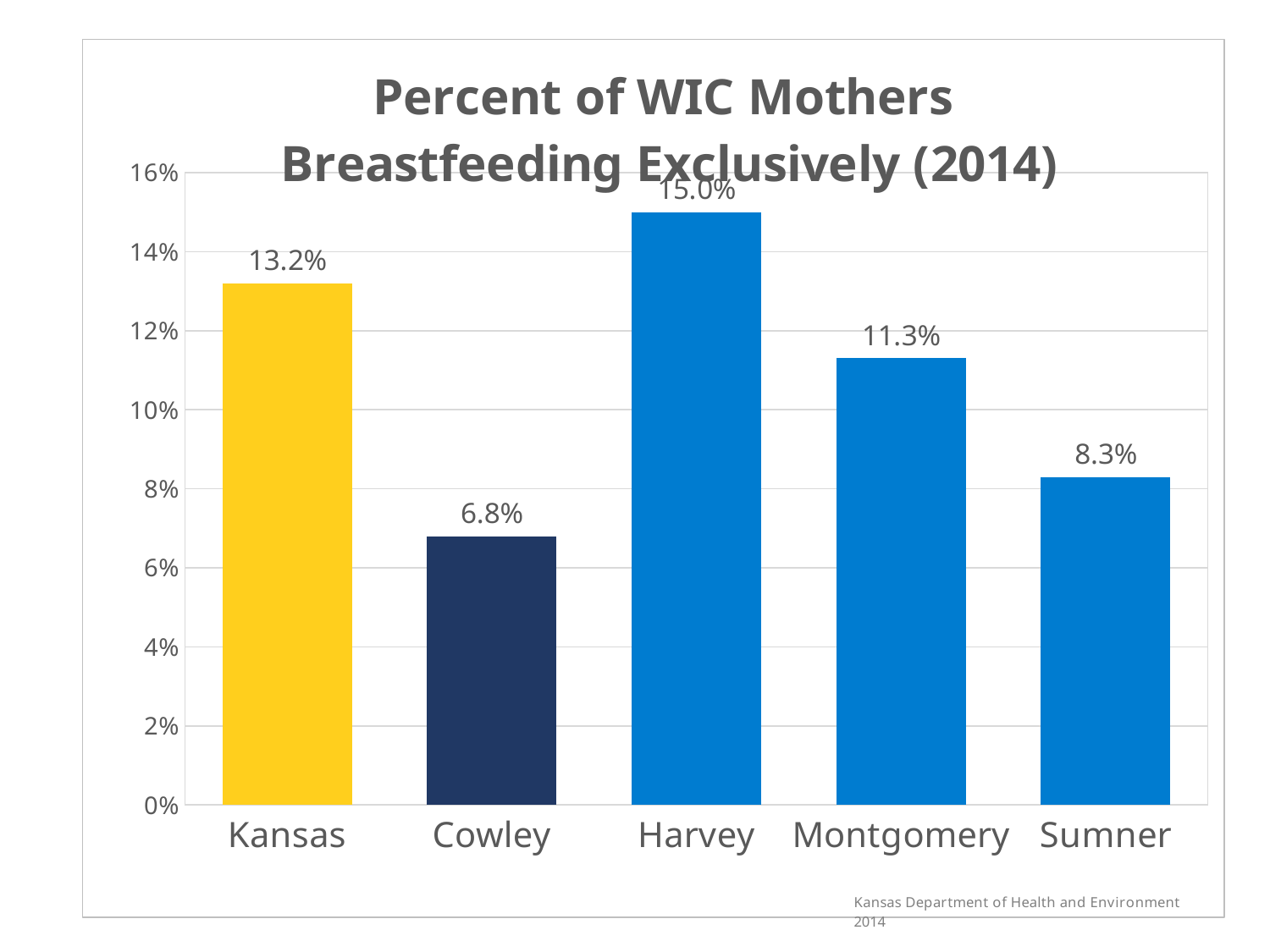
What is the difference between the values for Harvey and Cowley? 8.2% Which category has the highest value? Harvey What is the title of the chart? Percent of WIC Mothers Breastfeeding Exclusively (2014) What is the value for Sumner? 8.3% What kind of chart is shown on the slide? Bar chart What is the value for Harvey? 15.0% Which category has the lowest value? Cowley What is the value for Cowley? 6.8% What is the value for Kansas? 13.2% What is the value for Montgomery? 11.3% How many categories are shown on the x axis? 5 Which is larger, the value for Montgomery or the value for Sumner? Montgomery